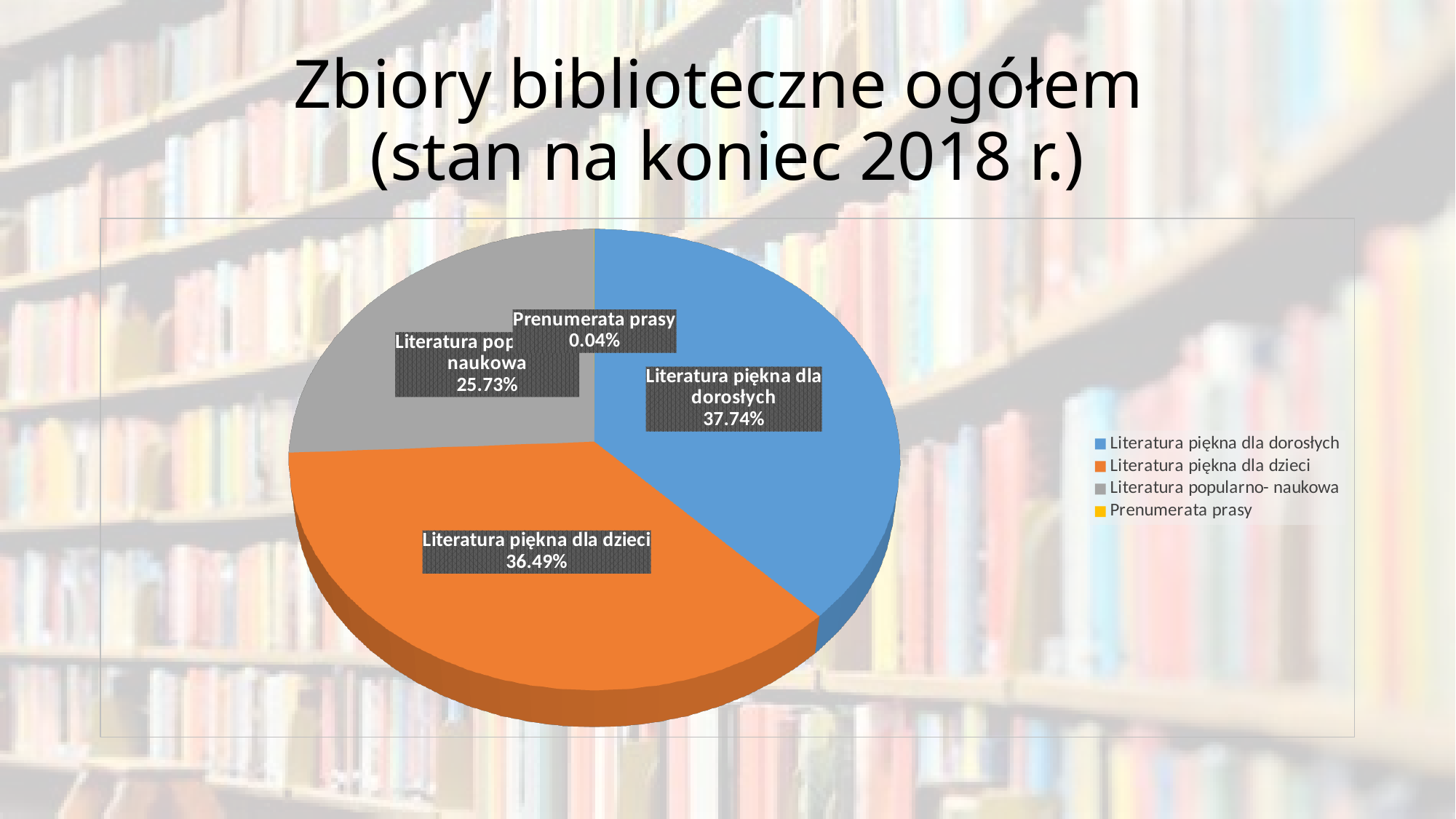
What is the title of the chart slide? Zbiory biblioteczne ogółem (stan na koniec 2018 r.) What kind of chart is shown on the slide? pie chart What share of the pie does Prenumerata prasy have? 0.04% Which category has the smallest share of the pie? Prenumerata prasy What share of the pie does Literatura piękna dla dorosłych have? 37.74% What share of the pie does Literatura popularno- naukowa have? 25.73% Which category has the largest share of the pie? Literatura piękna dla dorosłych What is the difference in percentage points between Literatura piękna dla dzieci and Literatura popularno- naukowa? 10.76 What is the difference in percentage points between Literatura piękna dla dorosłych and Literatura piękna dla dzieci? 1.25 How many categories does the legend list? 4 Which is larger, the share for Literatura piękna dla dzieci or for Literatura popularno- naukowa? Literatura piękna dla dzieci